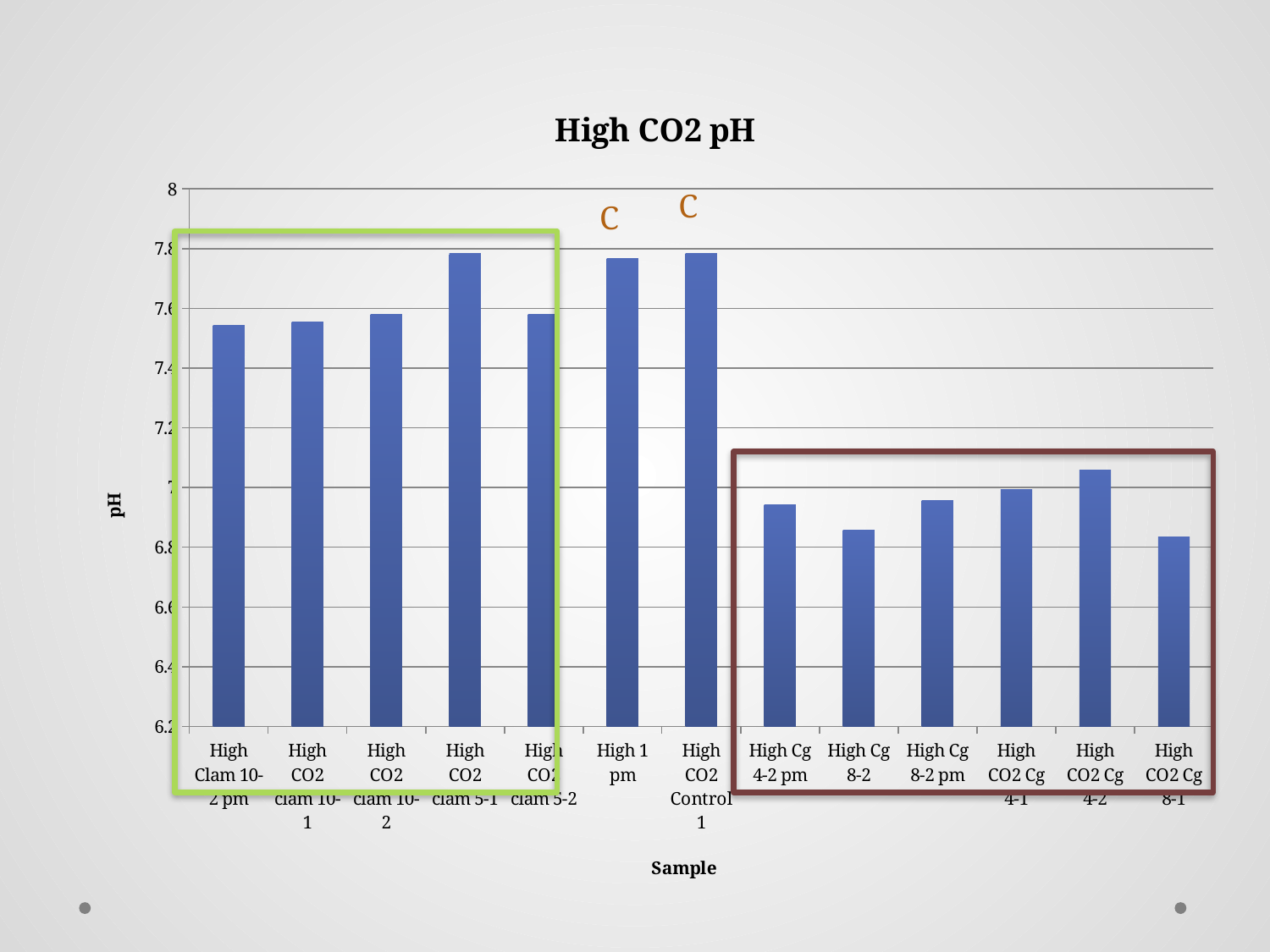
What is the title of the chart? High CO2 pH What type of chart is shown on the slide? bar chart Is the value for High CO2 Cg 8-1 greater or less than 7? less Which has a higher pH value, High 1 pm or High CO2 Cg 8-1? High 1 pm Is the value for High Cg 8-2 greater or less than 7? less Is the value for High Clam 10-2 pm greater or less than 7.4? greater What is the label on the vertical axis of the chart? pH Which has a higher pH value, High CO2 clam 10-2 or High Cg 8-2 pm? High CO2 clam 10-2 How many bars (samples) are plotted in the chart? 13 Which has a higher pH value, High CO2 clam 5-1 or High Cg 4-2 pm? High CO2 clam 5-1